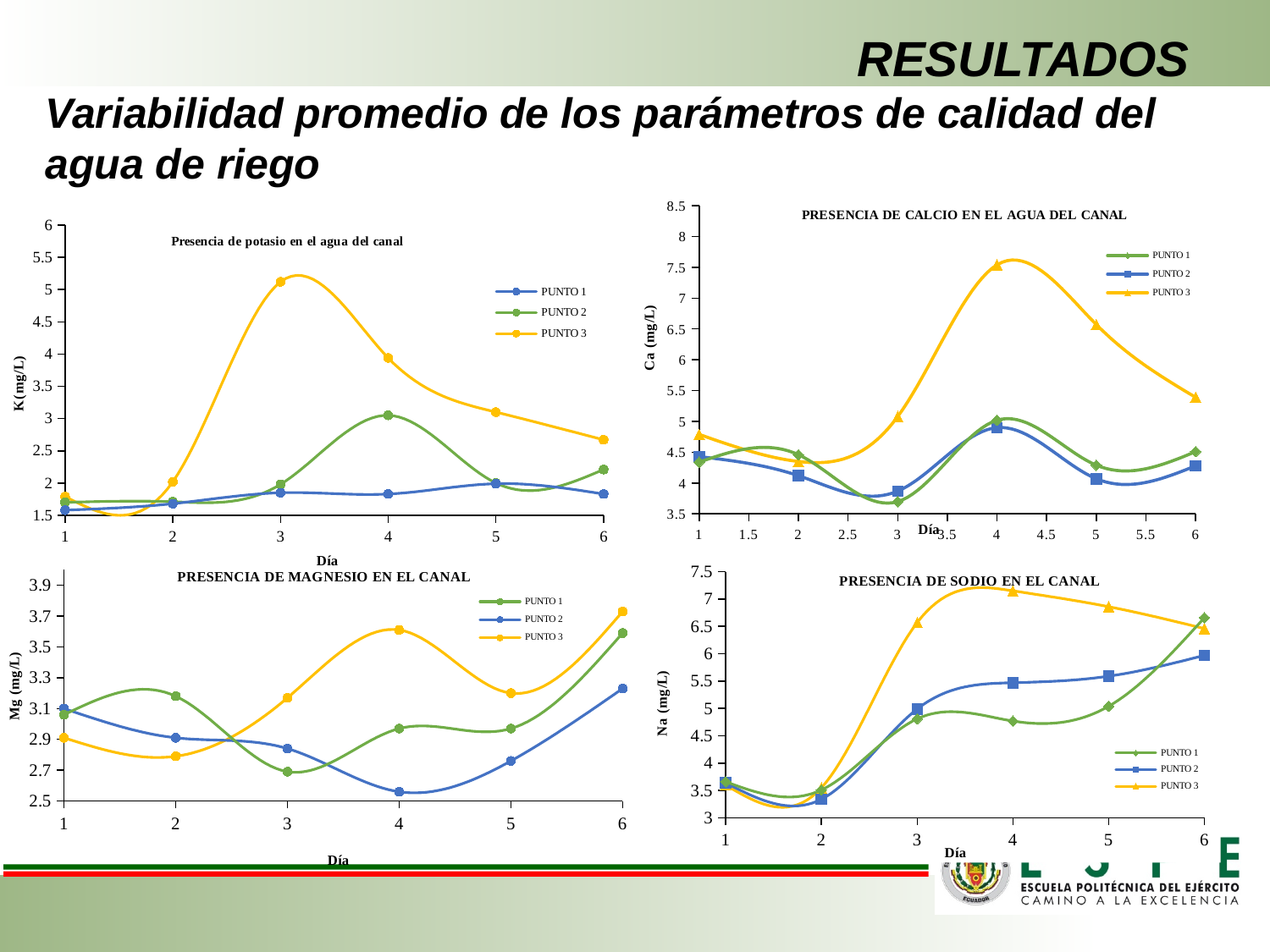
In the 'Presencia de potasio en el agua del canal' chart, which series has the highest value on day 3? PUNTO 3 In the 'PRESENCIA DE MAGNESIO EN EL CANAL' chart, on which day does PUNTO 2 reach its lowest value? 4 In the 'PRESENCIA DE CALCIO EN EL AGUA DEL CANAL' chart, is the value for PUNTO 3 on day 4 greater or less than 7? greater What kind of chart is the 'Presencia de potasio en el agua del canal' chart? line chart In the 'PRESENCIA DE SODIO EN EL CANAL' chart, which is larger on day 6: PUNTO 1 or PUNTO 2? PUNTO 1 In the 'PRESENCIA DE CALCIO EN EL AGUA DEL CANAL' chart, on which day does PUNTO 1 reach its lowest value? 3 How many series does the legend of the 'PRESENCIA DE CALCIO EN EL AGUA DEL CANAL' chart list? 3 In the 'PRESENCIA DE MAGNESIO EN EL CANAL' chart, is the value for PUNTO 3 on day 4 greater or less than 3.5? greater What is the y-axis label of the 'PRESENCIA DE CALCIO EN EL AGUA DEL CANAL' chart? Ca (mg/L) In the 'Presencia de potasio en el agua del canal' chart, is the value for PUNTO 3 on day 3 greater or less than 4.5? greater How many days (x-axis points) are plotted in the 'PRESENCIA DE MAGNESIO EN EL CANAL' chart? 6 In the 'Presencia de potasio en el agua del canal' chart, which is larger on day 4: PUNTO 2 or PUNTO 3? PUNTO 3